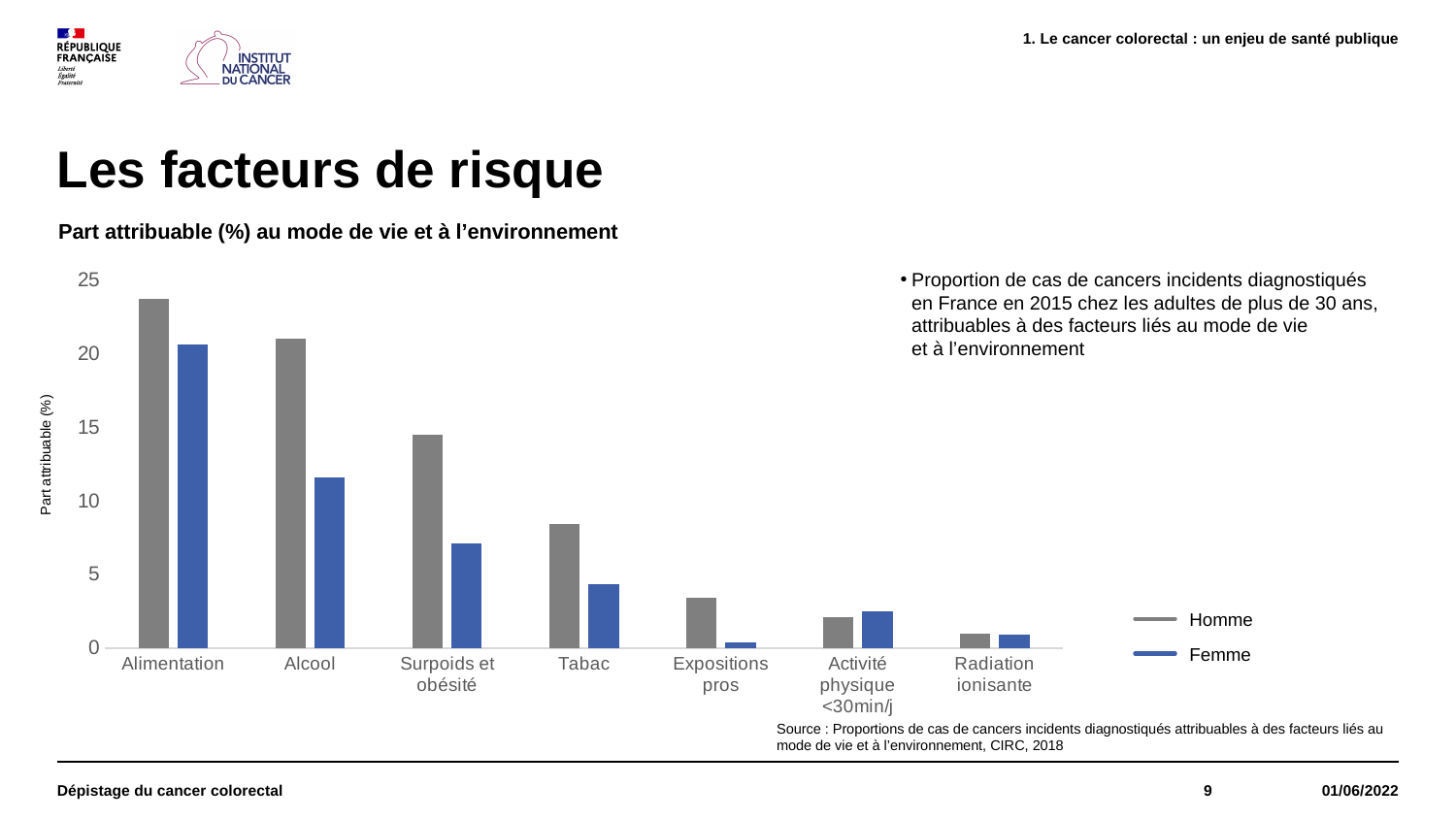
Which category has the lowest value for Femme? Expositions pros Is the Homme value for Alimentation greater or less than 20? greater Is the Homme value for Surpoids et obésité greater or less than 10? greater Which category has the highest value for Homme? Alimentation Is the Femme value for Surpoids et obésité greater or less than 10? less What are the two entries in the chart legend? Homme, Femme For Alcool, which is larger, the Homme value or the Femme value? Homme What is the label on the y axis of the chart? Part attribuable (%) What kind of chart is shown on the slide? bar chart How many series does the legend list? 2 How many risk factor categories are shown on the x axis? 7